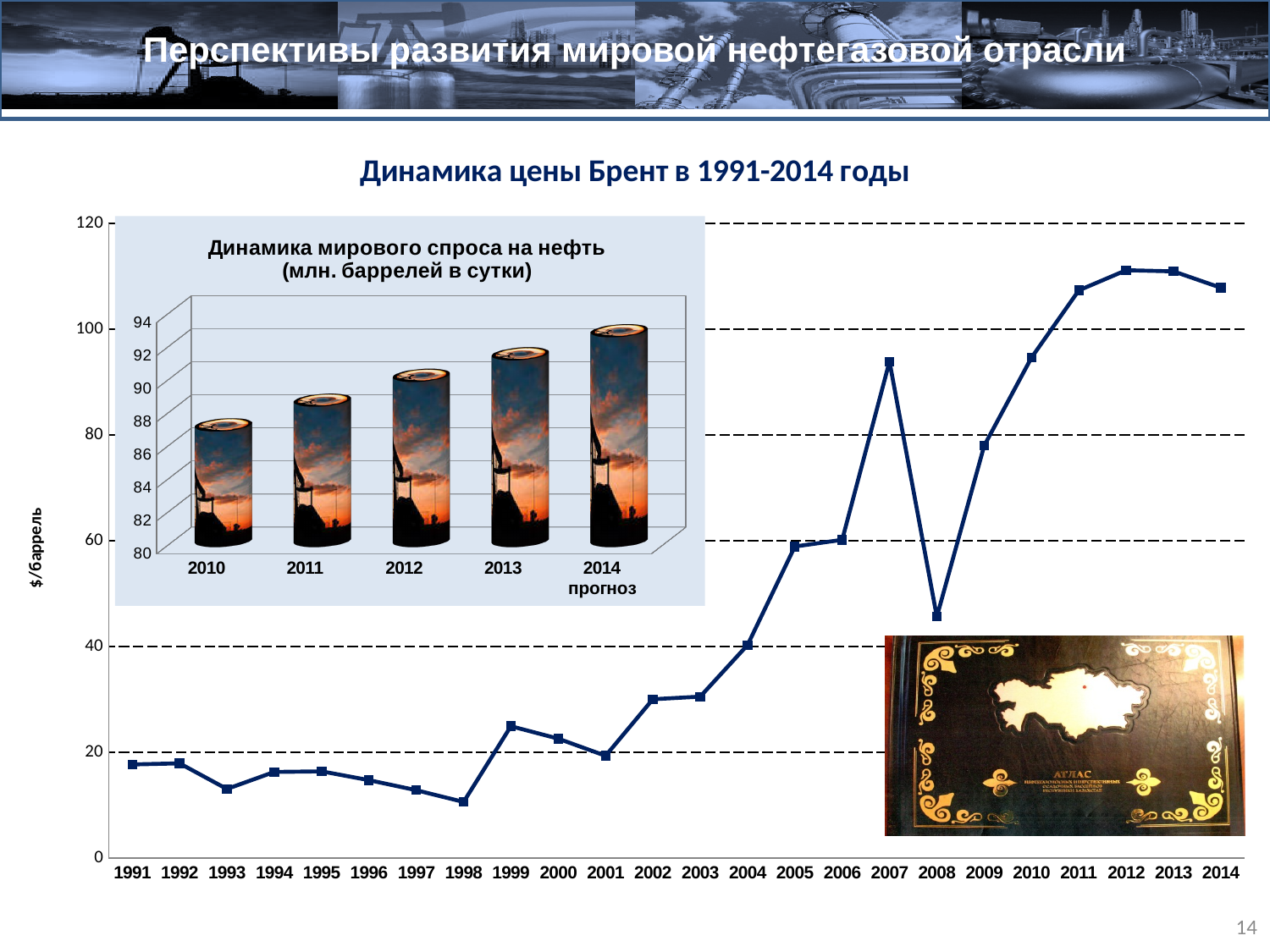
In the Brent price line chart, is the value for 2007 greater or less than 80? greater In the Brent price line chart, is the value for 2008 greater or less than 60? less In the Brent price line chart, how many years are shown on the x axis? 24 In the inset chart "Динамика мирового спроса на нефть", which year has the lowest value? 2010 What is the label on the vertical axis of the Brent price line chart? $/баррель In the inset chart "Динамика мирового спроса на нефть", which year has the highest value? 2014 In the inset chart "Динамика мирового спроса на нефть", do the values rise or fall from 2010 to 2014? rise What kind of chart is the large chart titled "Динамика цены Брент в 1991-2014 годы"? line chart In the Brent price line chart, which year has the lowest value? 1998 In the inset chart "Динамика мирового спроса на нефть", how many years are shown? 5 What kind of chart is the inset chart titled "Динамика мирового спроса на нефть"? bar chart In the Brent price line chart, which is larger, the value for 2007 or the value for 2008? 2007